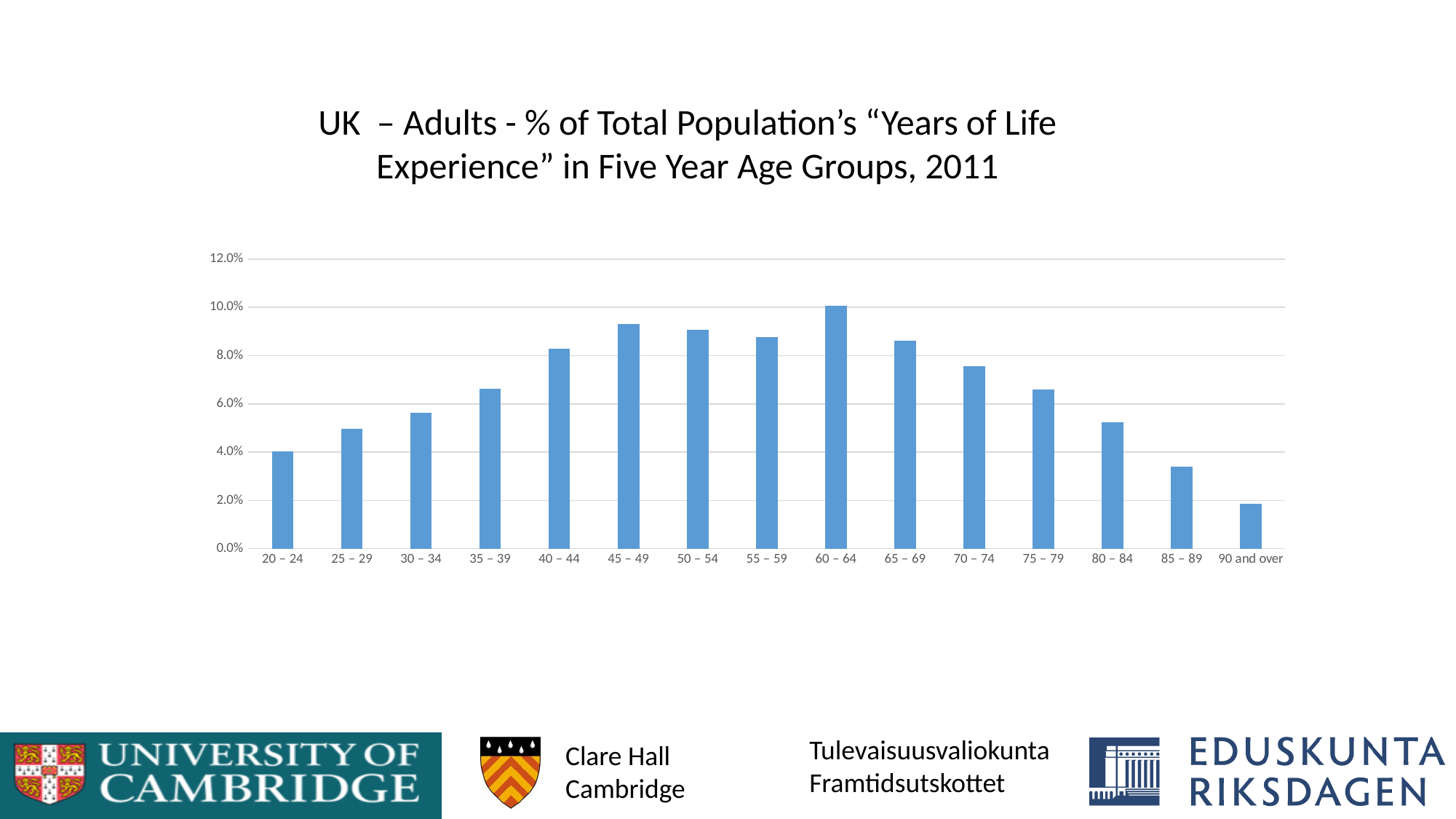
Which age group has the highest share of total population's years of life experience? 60 – 64 Which has the larger value, the 40 – 44 age group or the 70 – 74 age group? 40 – 44 Is the value for the 85 – 89 age group greater or less than 4.0%? less Is the value for the 40 – 44 age group greater or less than 8.0%? greater Which age group has the lowest share of total population's years of life experience? 90 and over Is the value for the 70 – 74 age group greater or less than 8.0%? less How many age groups are shown on the x axis? 15 Which has the larger value, the 45 – 49 age group or the 65 – 69 age group? 45 – 49 What year does the chart title say the data is for? 2011 What kind of chart is shown on the slide? bar chart